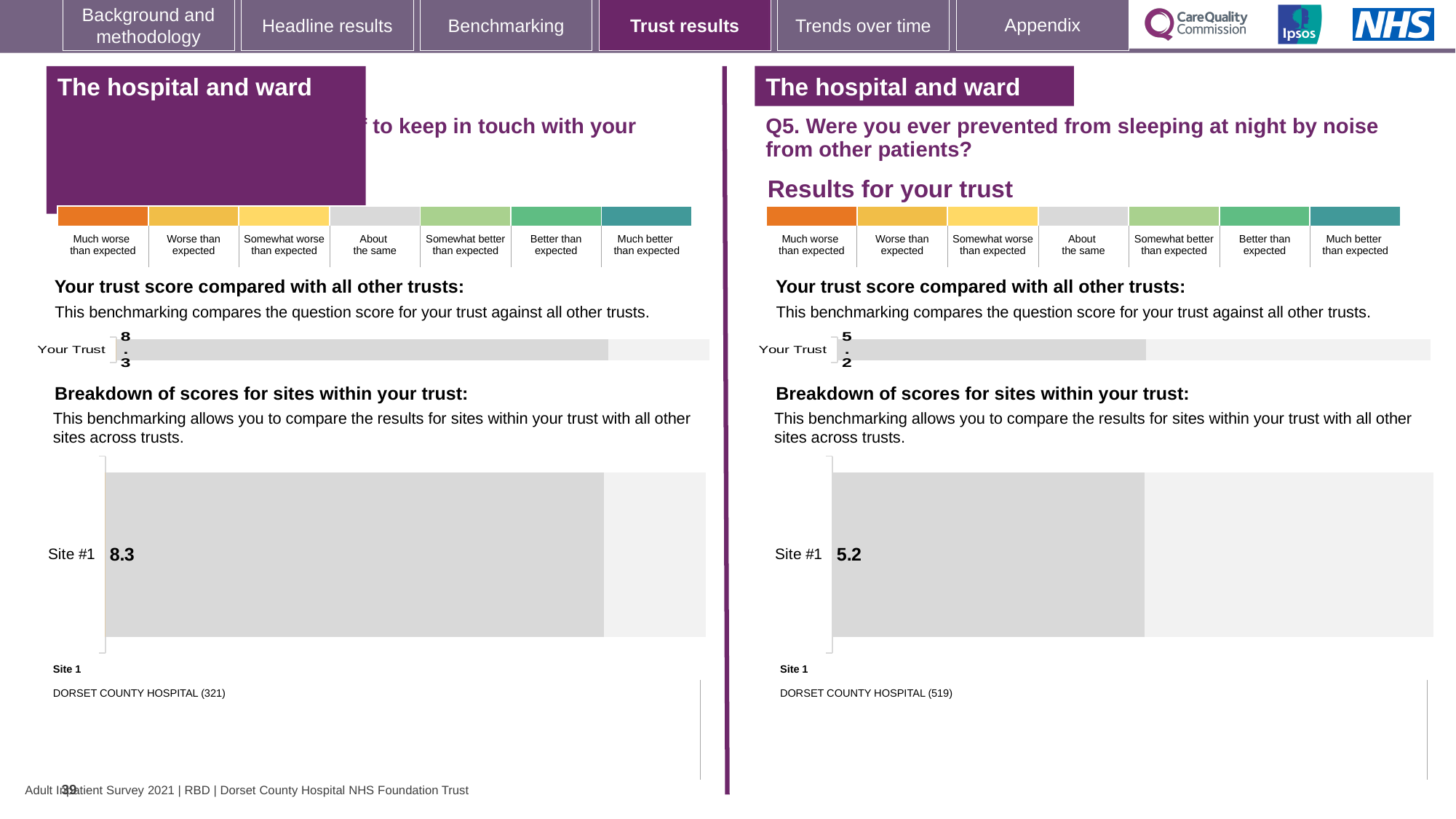
How many categories are shown in the coloured benchmarking scale above the 'Your trust score compared with all other trusts' chart on the right-hand panel? 7 What type of chart is used to show the Site #1 score on the right-hand panel (Q5)? Bar chart On the right-hand panel (Q5), which hospital is listed as Site 1 below the breakdown chart? DORSET COUNTY HOSPITAL (519) On the left-hand panel, what is the score shown for 'Your Trust' in the trust comparison bar chart? 8.3 How many sites are shown in the breakdown of scores for sites chart on the right-hand panel (Q5)? 1 On the right-hand panel (Q5), what score is shown for Site #1 in the breakdown of scores for sites chart? 5.2 On the right-hand panel (Q5), what is the score shown for 'Your Trust' in the trust comparison bar chart? 5.2 How many bars are plotted in the 'Your Trust' chart on the left-hand panel? 1 What is the difference between the Site #1 score on the left-hand panel and the Site #1 score on the right-hand panel (Q5)? 3.1 On the left-hand panel, what score is shown for Site #1 in the breakdown of scores for sites chart? 8.3 Which panel shows the higher Site #1 score, the left-hand panel or the right-hand panel (Q5)? Left-hand panel Is the Site #1 score on the right-hand panel (Q5) greater or less than the Site #1 score on the left-hand panel? less